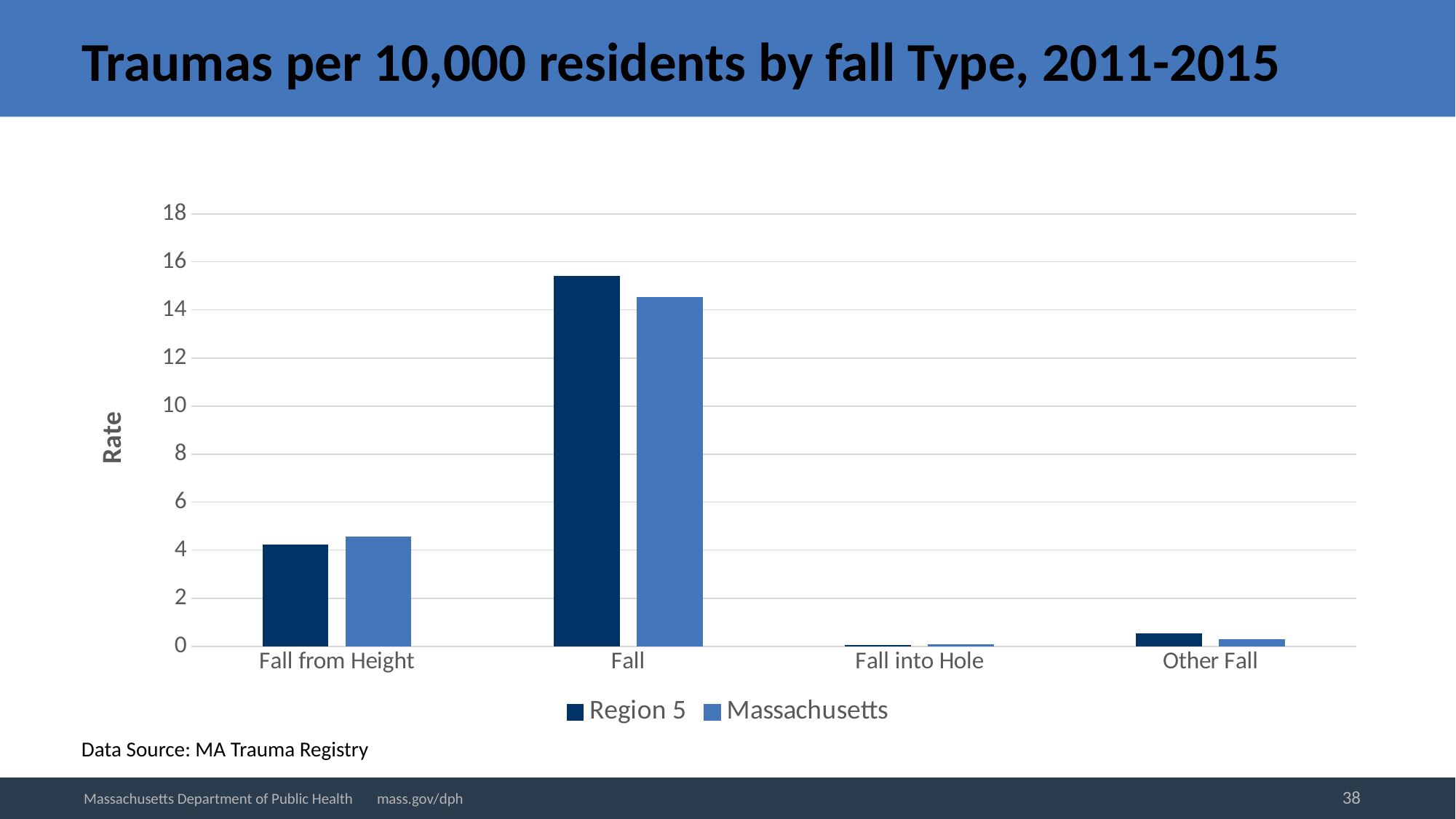
How many fall type categories are shown on the x axis? 4 Is the Region 5 value for Other Fall greater or less than 2? less What is the title of the chart on the slide? Traumas per 10,000 residents by fall Type, 2011-2015 Which fall type has the highest rate for Region 5? Fall Which fall type has the lowest rate for Massachusetts? Fall into Hole For the Fall from Height category, which is larger: the Region 5 rate or the Massachusetts rate? Massachusetts Is the Massachusetts value for Fall from Height greater or less than 6? less What is the label on the y axis of the chart? Rate What kind of chart is shown on the slide? bar chart Is the Region 5 value for Fall greater or less than 14? greater For the Fall category, which is larger: the Region 5 rate or the Massachusetts rate? Region 5 How many series does the legend list? 2